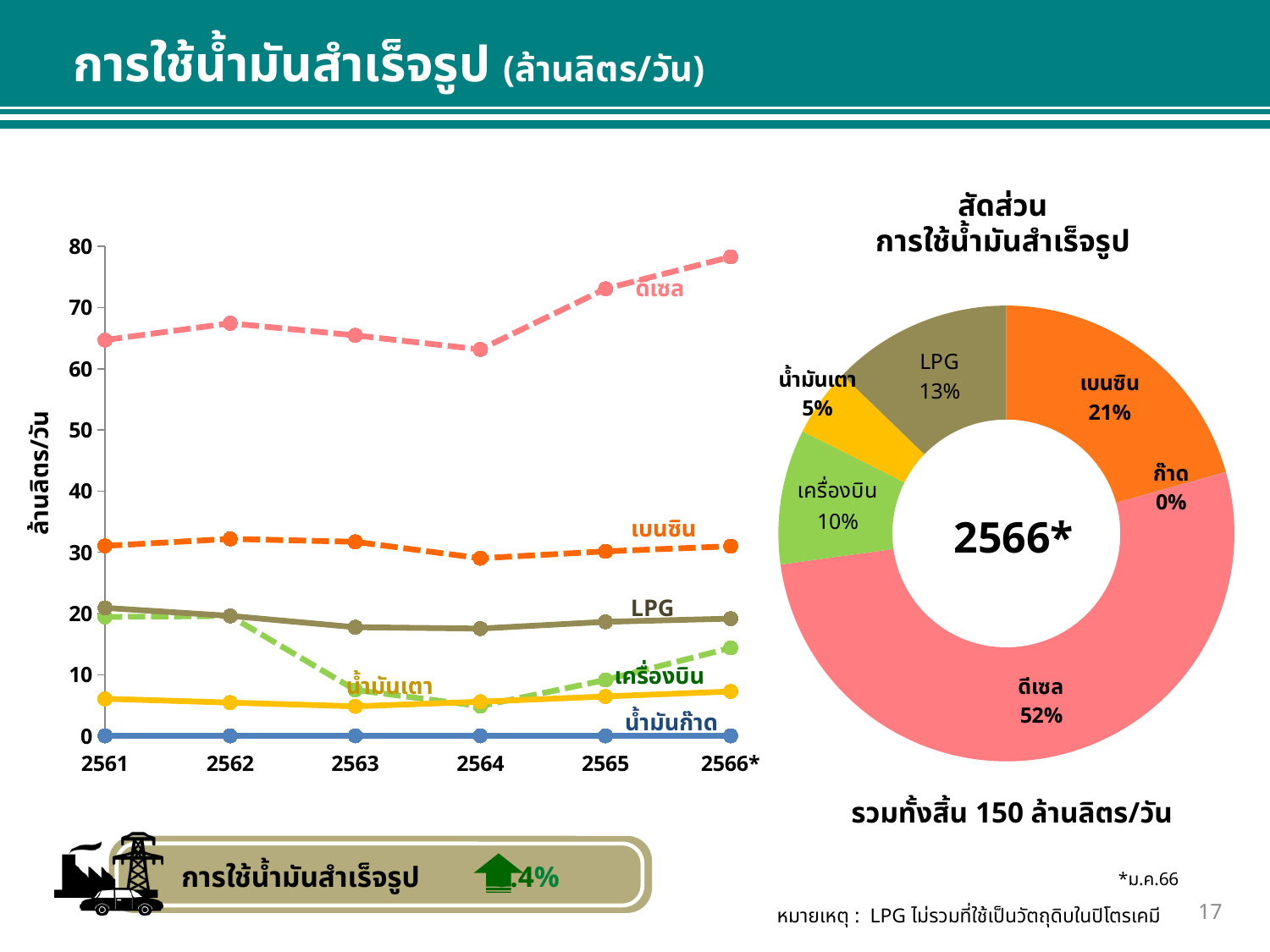
In the line chart on the left, is the value for ดีเซล in 2566* greater or less than 70? greater In the line chart on the left, is the value for LPG in 2563 greater or less than 20? less In the line chart on the left, does the ดีเซล line rise or fall from 2564 to 2566*? rise In the pie chart on the right, how many percentage points larger is the share of เบนซิน than the share of เครื่องบิน? 11 In the pie chart on the right, which category has the smallest share? ก๊าด In the pie chart on the right, what share does ดีเซล have? 52% In the pie chart on the right, which category has the largest share? ดีเซล What kind of chart is the chart on the left side of the slide? line chart In the line chart on the left, which series has the highest values across all years? ดีเซล In the pie chart on the right, how many categories are shown? 6 In the pie chart on the right, what share does LPG have? 13% What kind of chart is the chart on the right side of the slide (สัดส่วนการใช้น้ำมันสำเร็จรูป)? doughnut chart